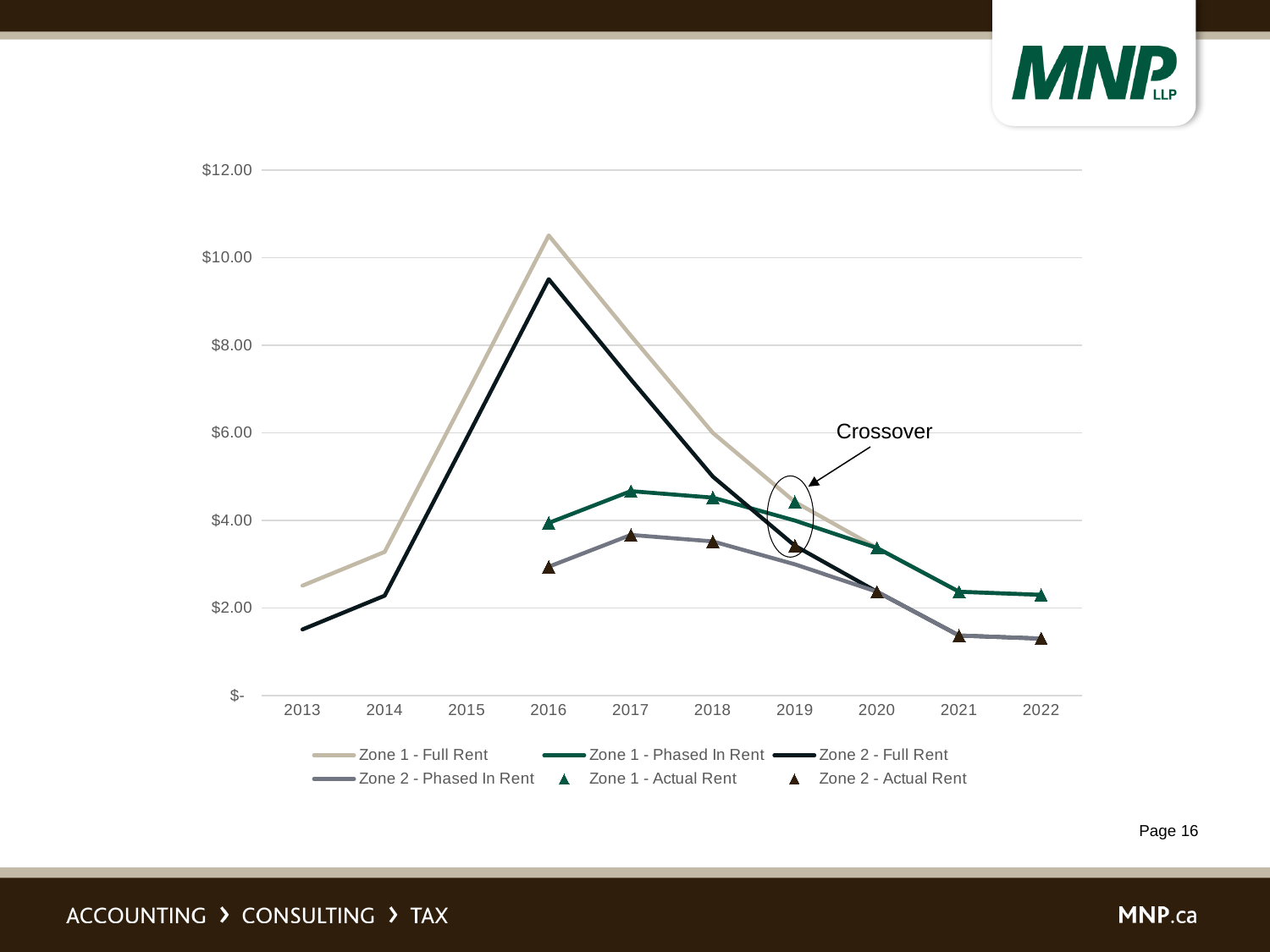
What kind of chart is shown on the slide? Line chart In 2016, which is larger: Zone 1 - Full Rent or Zone 2 - Full Rent? Zone 1 - Full Rent How many series does the legend list? 6 How many years are shown on the x axis? 10 Does Zone 1 - Full Rent rise or fall from 2016 to 2022? Fall Is the value for Zone 1 - Phased In Rent in 2017 greater or less than $4.00? greater Is the value for Zone 2 - Phased In Rent in 2022 greater or less than $2.00? less Is the value for Zone 2 - Full Rent in 2016 greater or less than $10.00? less In which year does Zone 1 - Full Rent reach its highest value? 2016 What word does the annotation next to the circled point on the chart say? Crossover